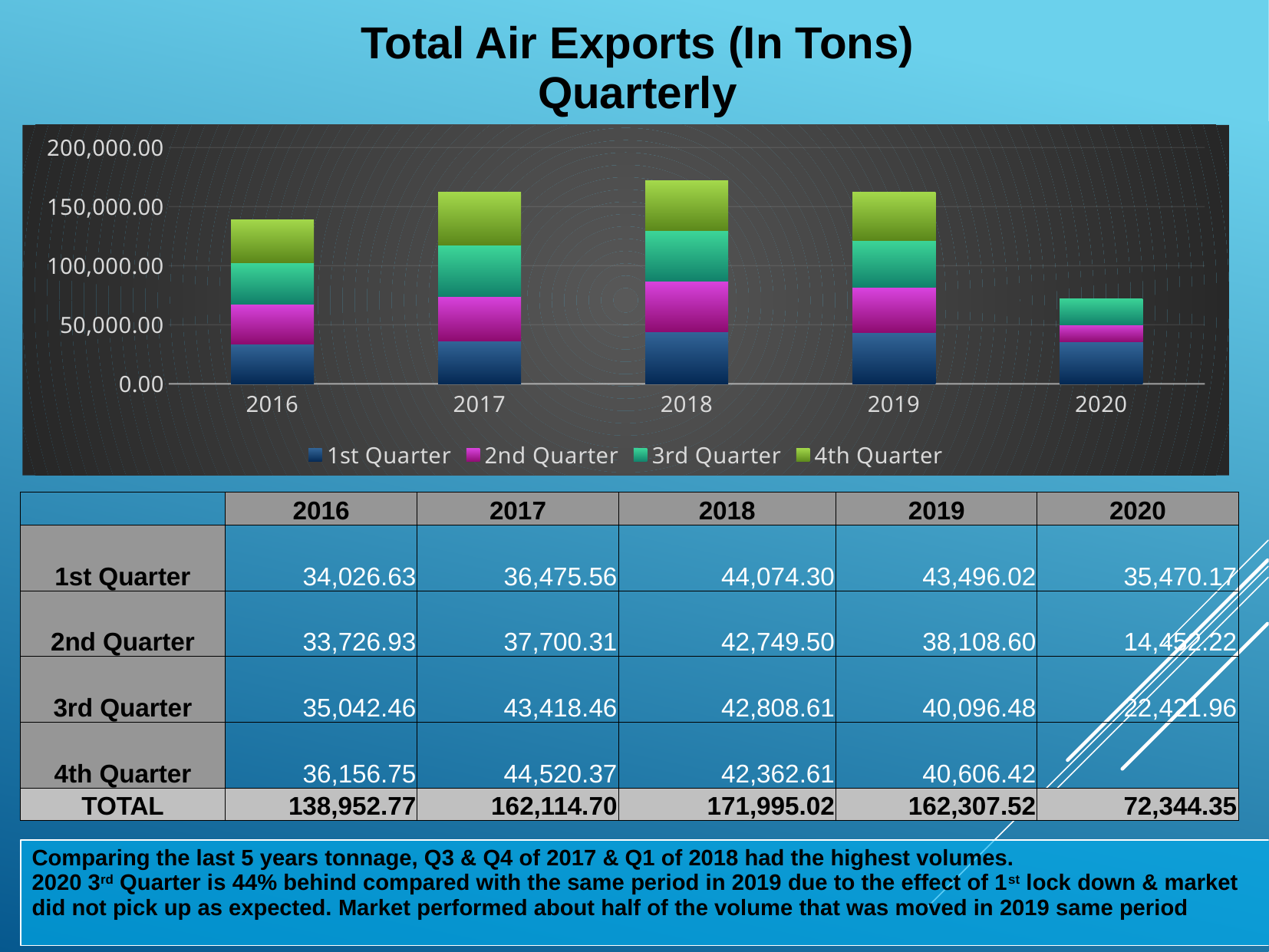
Is the total for 2020 greater or less than 100,000.00? less Which series is shown in green at the top of each stacked bar? 4th Quarter What is the 1st Quarter value for 2019? 43,496.02 What is the 4th Quarter value for 2017? 44,520.37 What is the difference between the 2018 total and the 2016 total? 33,042.25 Which is larger, the 3rd Quarter value for 2017 or the 3rd Quarter value for 2019? 2017 What is the total air exports value for 2018? 171,995.02 Which year has the lowest total air exports? 2020 How many series does the chart legend list? 4 How many years are shown on the x axis of the chart? 5 What kind of chart is shown on the slide? Stacked bar chart Which year has the highest total air exports? 2018